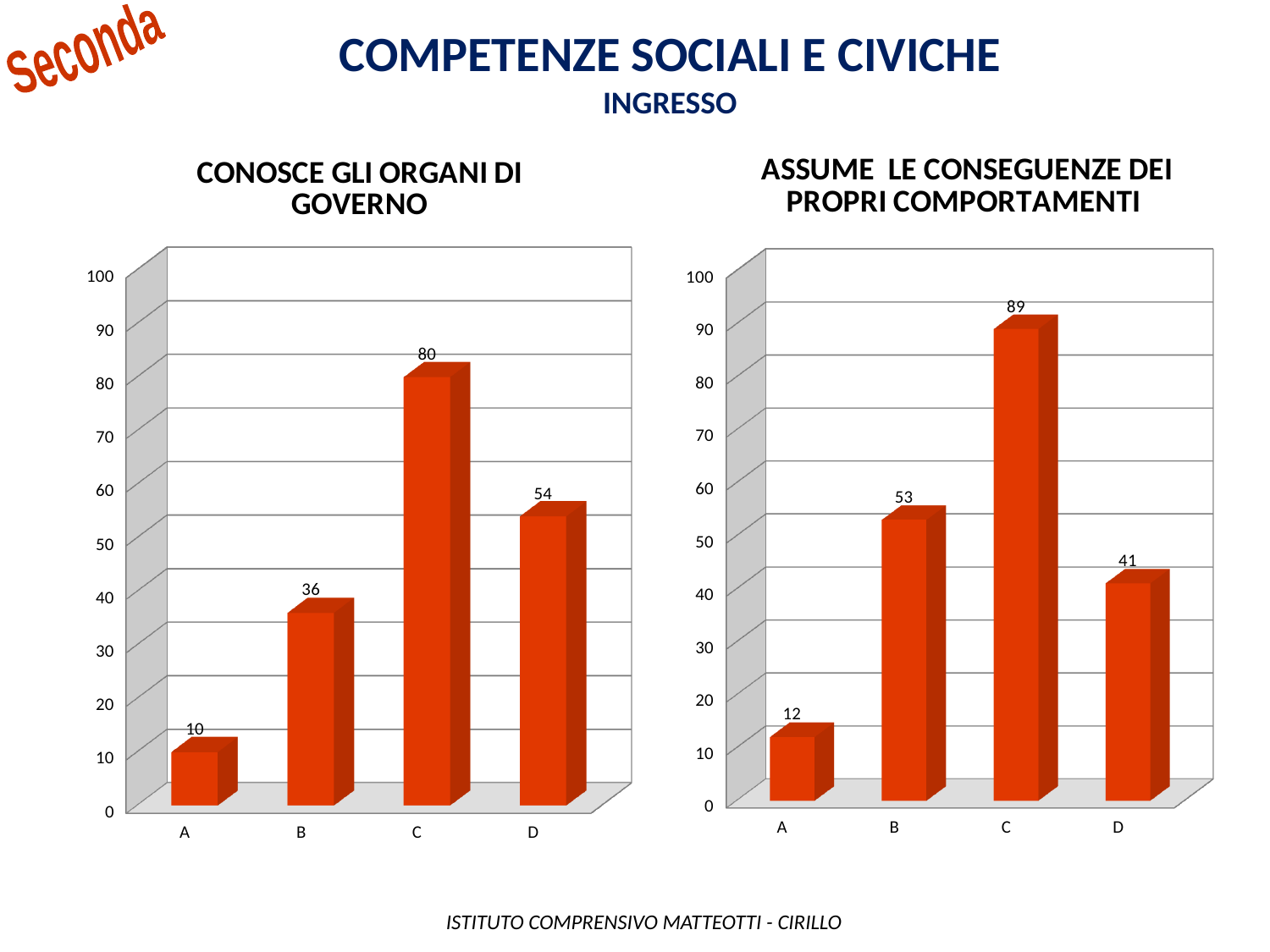
In the chart titled 'ASSUME LE CONSEGUENZE DEI PROPRI COMPORTAMENTI', what is the difference between the values for B and D? 12 In the chart titled 'ASSUME LE CONSEGUENZE DEI PROPRI COMPORTAMENTI', which category has the highest value? C In the chart titled 'CONOSCE GLI ORGANI DI GOVERNO', which category has the lowest value? A What is the title of the chart on the right side of the slide? ASSUME LE CONSEGUENZE DEI PROPRI COMPORTAMENTI What kind of chart is the chart titled 'ASSUME LE CONSEGUENZE DEI PROPRI COMPORTAMENTI'? Bar chart How many categories are shown in the chart titled 'CONOSCE GLI ORGANI DI GOVERNO'? 4 In the chart titled 'CONOSCE GLI ORGANI DI GOVERNO', what is the difference between the values for C and D? 26 In the chart titled 'CONOSCE GLI ORGANI DI GOVERNO', what is the value for category A? 10 In the chart titled 'CONOSCE GLI ORGANI DI GOVERNO', what is the value for category C? 80 In the chart titled 'ASSUME LE CONSEGUENZE DEI PROPRI COMPORTAMENTI', what is the value for category B? 53 In the chart titled 'CONOSCE GLI ORGANI DI GOVERNO', which is larger, the value for B or the value for D? D In the chart titled 'ASSUME LE CONSEGUENZE DEI PROPRI COMPORTAMENTI', is the value for D greater or less than 50? less